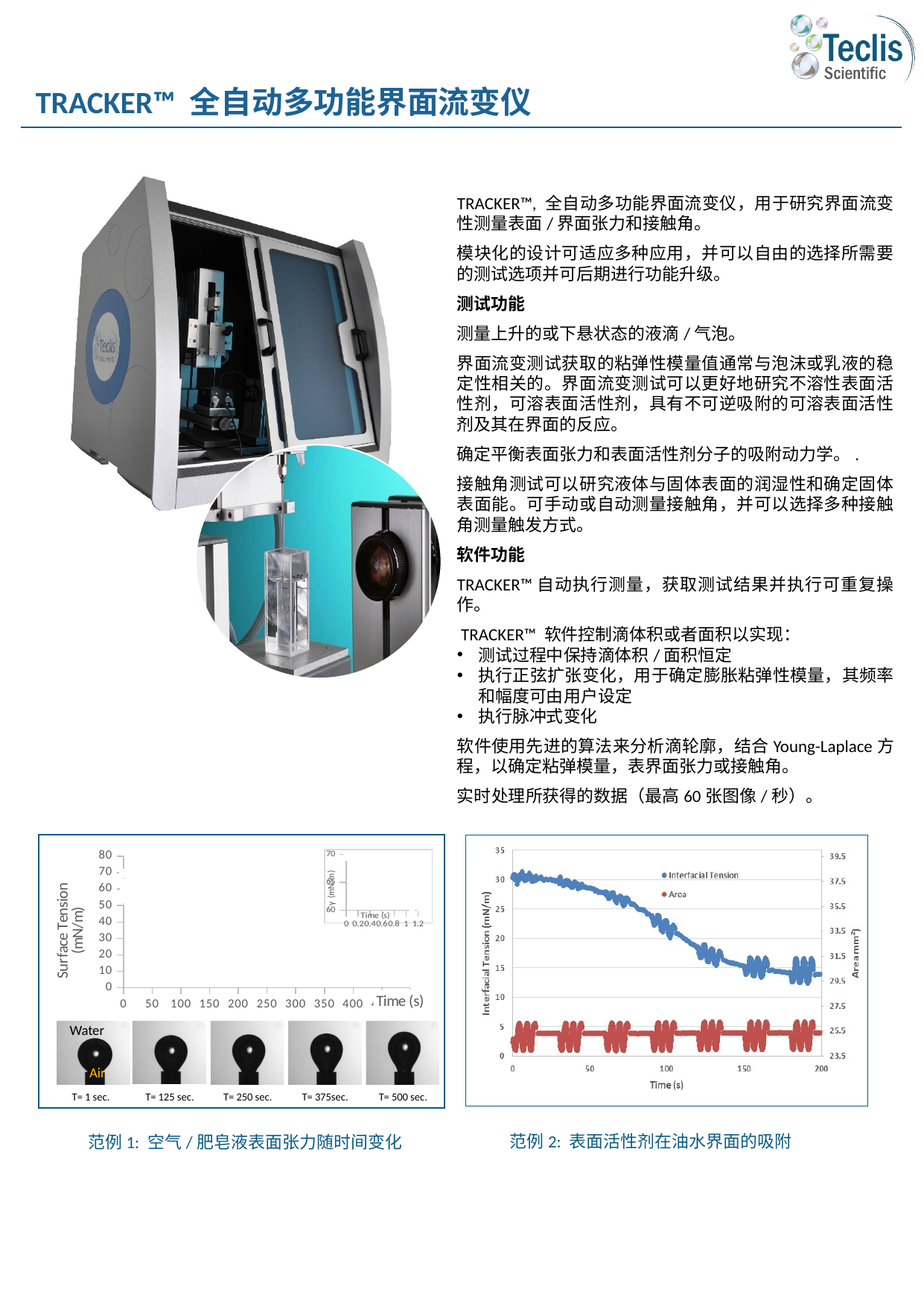
In the left chart (范例 1), what time is labelled under the last drop image? T= 500 sec. In the right chart (范例 2), is the Interfacial Tension value at time 0 s greater or less than 25 mN/m? greater In the right chart (范例 2), does the Interfacial Tension series rise or fall as time increases from 0 to 200 s? fall In the right chart (范例 2), is the Interfacial Tension value at time 150 s greater or less than 20 mN/m? less In the right chart (范例 2), what are the two series named in the legend? Interfacial Tension and Area In the right chart (范例 2), how many series does the legend list? 2 In the right chart (范例 2), is the Interfacial Tension value at time 50 s greater or less than 25 mN/m? greater In the right chart (范例 2), what is the highest tick value shown on the Time (s) axis? 200 In the left chart (范例 1), what is the highest tick value shown on the Surface Tension (mN/m) axis? 80 In the left chart (范例 1), how many drop images are shown below the plot? 5